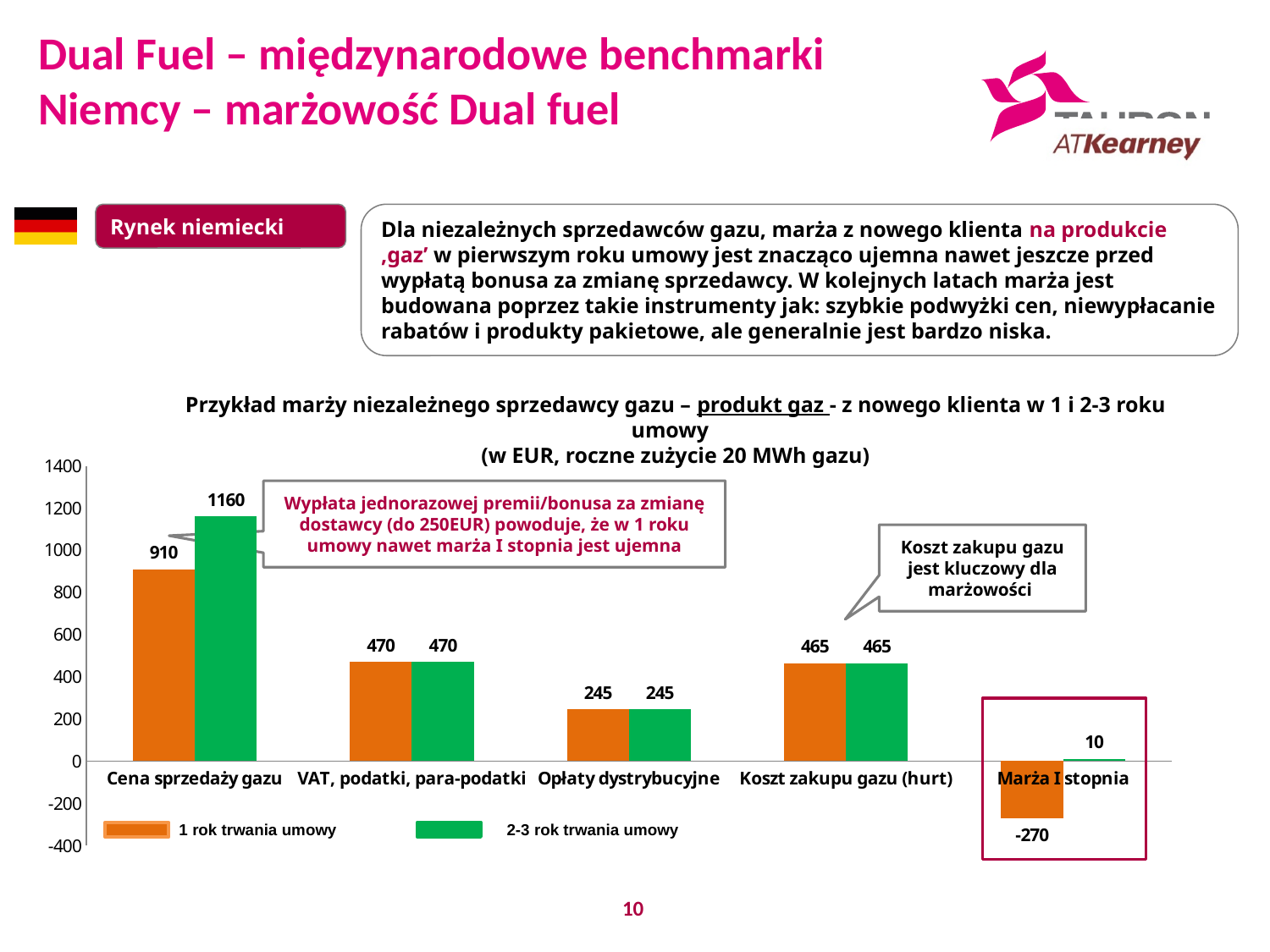
What is the value for 'Cena sprzedaży gazu' in the '1 rok trwania umowy' series? 910 What is the value for 'Opłaty dystrybucyjne' in the '2-3 rok trwania umowy' series? 245 What kind of chart is shown on the slide? Bar chart How many series does the chart legend list? 2 What is the value for 'Cena sprzedaży gazu' in the '2-3 rok trwania umowy' series? 1160 Which category has the lowest value in the '1 rok trwania umowy' series? Marża I stopnia How many categories are shown on the x axis of the chart? 5 Which category has the highest value in the '2-3 rok trwania umowy' series? Cena sprzedaży gazu What is the difference between the '2-3 rok trwania umowy' and '1 rok trwania umowy' values for 'Cena sprzedaży gazu'? 250 What is the value for 'Marża I stopnia' in the '2-3 rok trwania umowy' series? 10 What is the value for 'Marża I stopnia' in the '1 rok trwania umowy' series? -270 Which is larger for 'Koszt zakupu gazu (hurt)': the '1 rok trwania umowy' value or the 'VAT, podatki, para-podatki' value in the same series? VAT, podatki, para-podatki